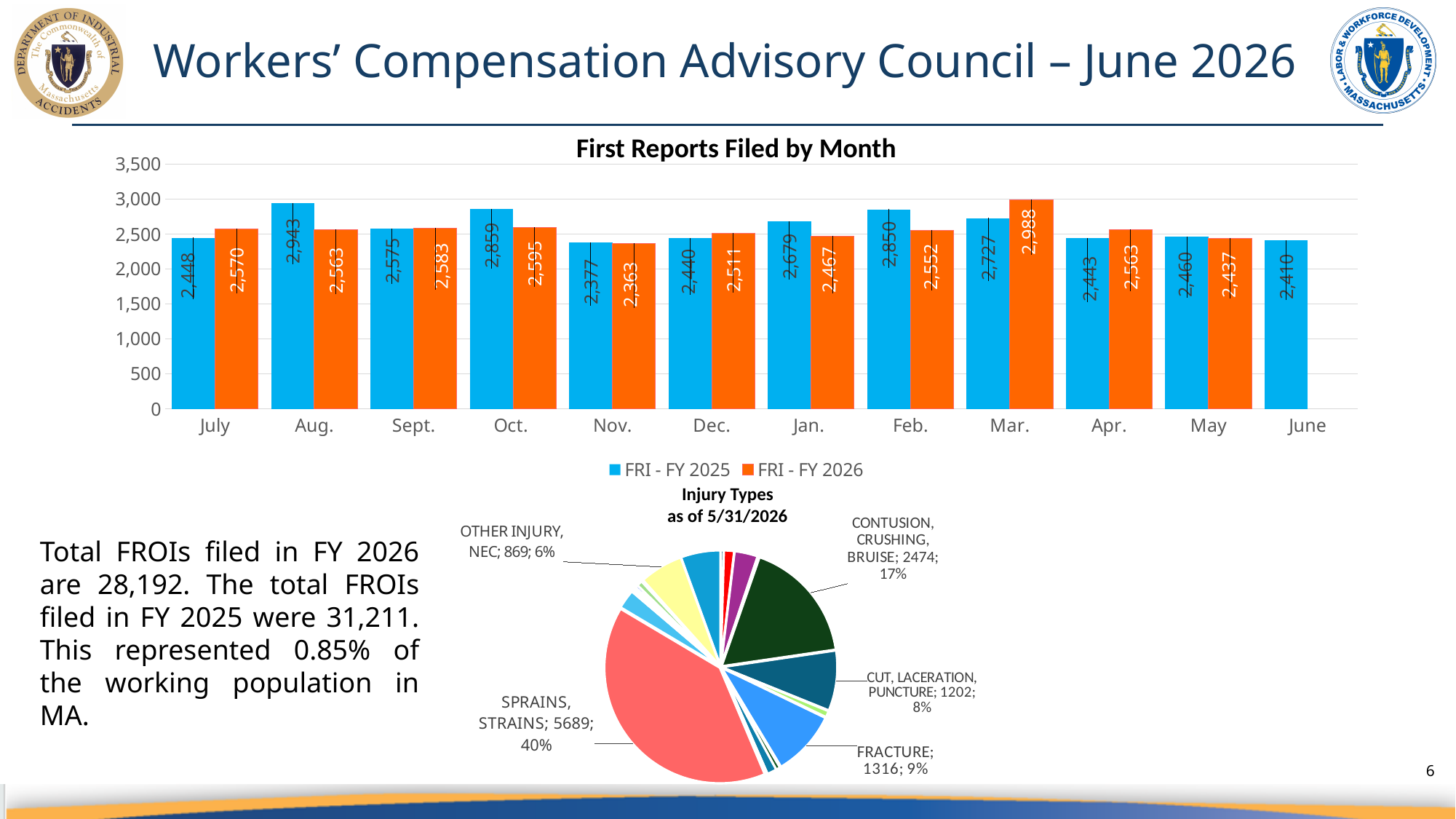
In the 'First Reports Filed by Month' chart, how many months are shown on the x axis? 12 In the 'First Reports Filed by Month' chart, which month has the highest FRI - FY 2025 value? Aug. In the 'First Reports Filed by Month' chart, what is the FRI - FY 2026 value for March? 2,988 In the 'First Reports Filed by Month' chart, what is the FRI - FY 2025 value for August? 2,943 What kind of chart is 'First Reports Filed by Month'? Bar chart In the 'First Reports Filed by Month' chart, how many series does the legend list? 2 In the 'First Reports Filed by Month' chart, which month has the lowest FRI - FY 2026 value? Nov. In the 'First Reports Filed by Month' chart, which is larger for December: FRI - FY 2025 or FRI - FY 2026? FRI - FY 2026 In the 'Injury Types as of 5/31/2026' pie chart, what share does SPRAINS, STRAINS have? 40% In the 'Injury Types as of 5/31/2026' pie chart, which is larger: CONTUSION, CRUSHING, BRUISE or CUT, LACERATION, PUNCTURE? CONTUSION, CRUSHING, BRUISE In the 'First Reports Filed by Month' chart, what is the difference between the FRI - FY 2025 and FRI - FY 2026 values for October? 264 In the 'Injury Types as of 5/31/2026' pie chart, what is the value for FRACTURE? 1316